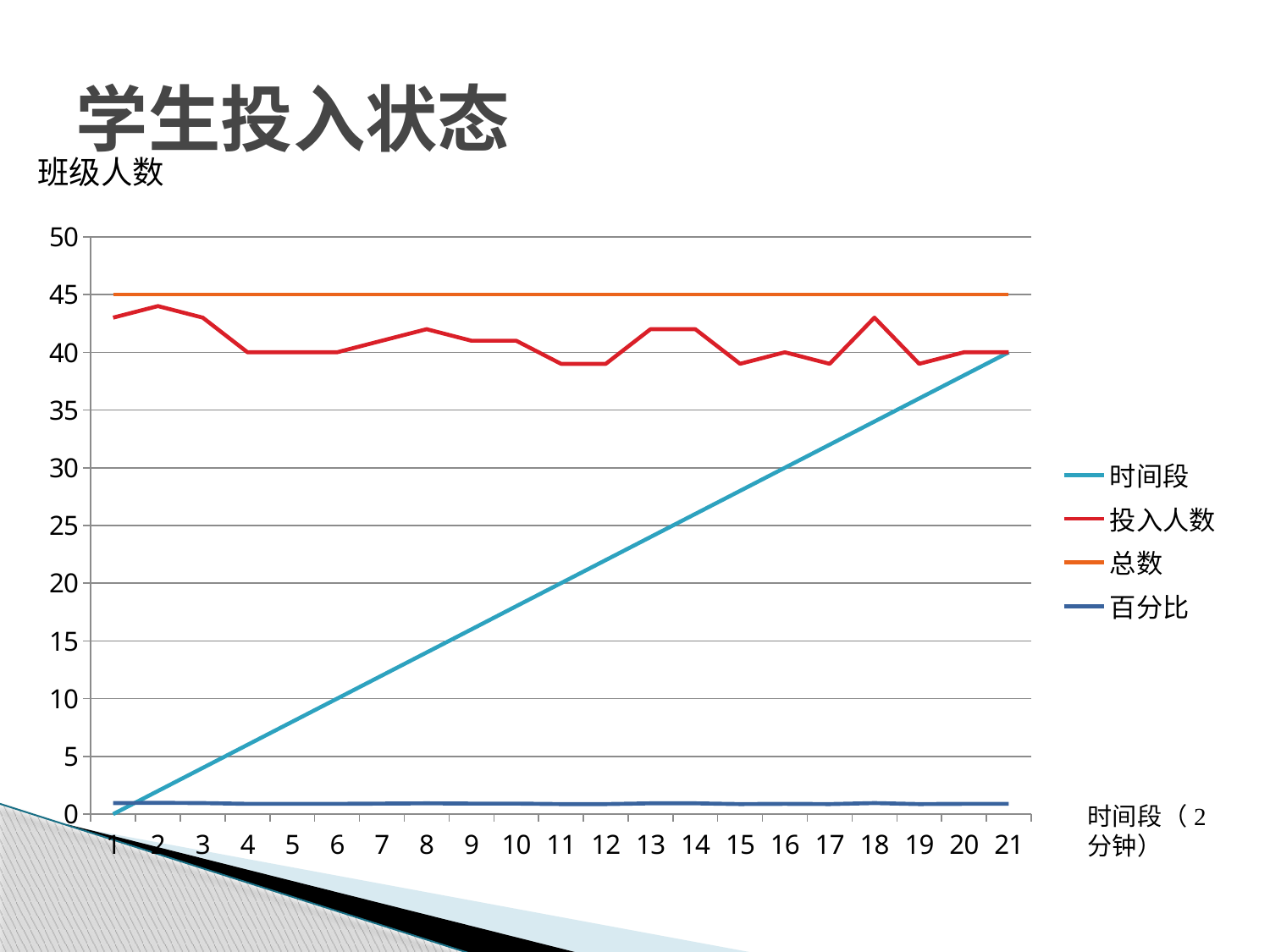
What is the value of 投入人数 at time period 4? 40 At time period 18, which is larger: 投入人数 or 时间段? 投入人数 Is the value of 投入人数 at time period 11 greater or less than 40? less What is the value of the 总数 series at time period 10? 45 How many series does the legend list? 4 Is the value of the 百分比 series at time period 15 greater or less than 5? less Is the value of 投入人数 at time period 2 greater or less than 40? greater What is the value of the 时间段 series at time period 21? 40 Does the 时间段 series rise or fall from time period 1 to 21? rise What is the title of the chart on the slide? 学生投入状态 What kind of chart is shown on the slide? line chart How many time periods are plotted along the x axis? 21